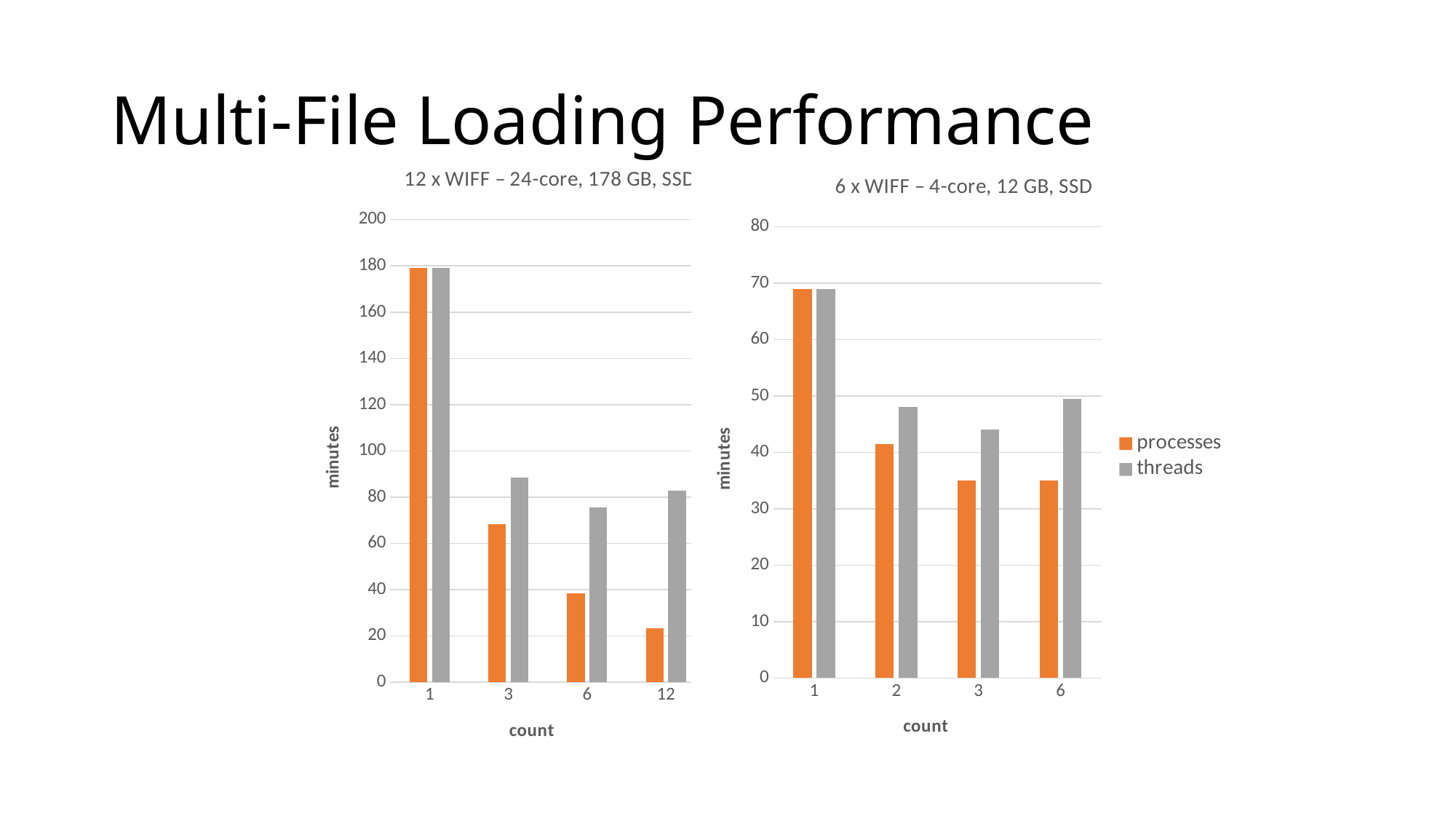
In the left chart (12 x WIFF – 24-core, 178 GB, SSD), at count 6, which series has the larger value, processes or threads? threads In the right chart (6 x WIFF – 4-core, 12 GB, SSD), is the processes value at count 2 greater or less than 40? greater What is the label on the y axis of the right chart titled "6 x WIFF – 4-core, 12 GB, SSD"? minutes How many count categories are shown on the x axis of the right chart titled "6 x WIFF – 4-core, 12 GB, SSD"? 4 In the left chart (12 x WIFF – 24-core, 178 GB, SSD), is the threads value at count 3 greater or less than 80? greater How many series does the legend list for the charts on this slide? 2 In the right chart (6 x WIFF – 4-core, 12 GB, SSD), at count 3, which series has the larger value, processes or threads? threads What kind of chart is the left chart titled "12 x WIFF – 24-core, 178 GB, SSD"? bar chart In the left chart (12 x WIFF – 24-core, 178 GB, SSD), which count has the lowest processes value? 12 In the left chart (12 x WIFF – 24-core, 178 GB, SSD), do the processes values rise or fall as count increases? fall In the left chart (12 x WIFF – 24-core, 178 GB, SSD), is the processes value at count 12 greater or less than 40? less In the right chart (6 x WIFF – 4-core, 12 GB, SSD), which count has the highest threads value? 1